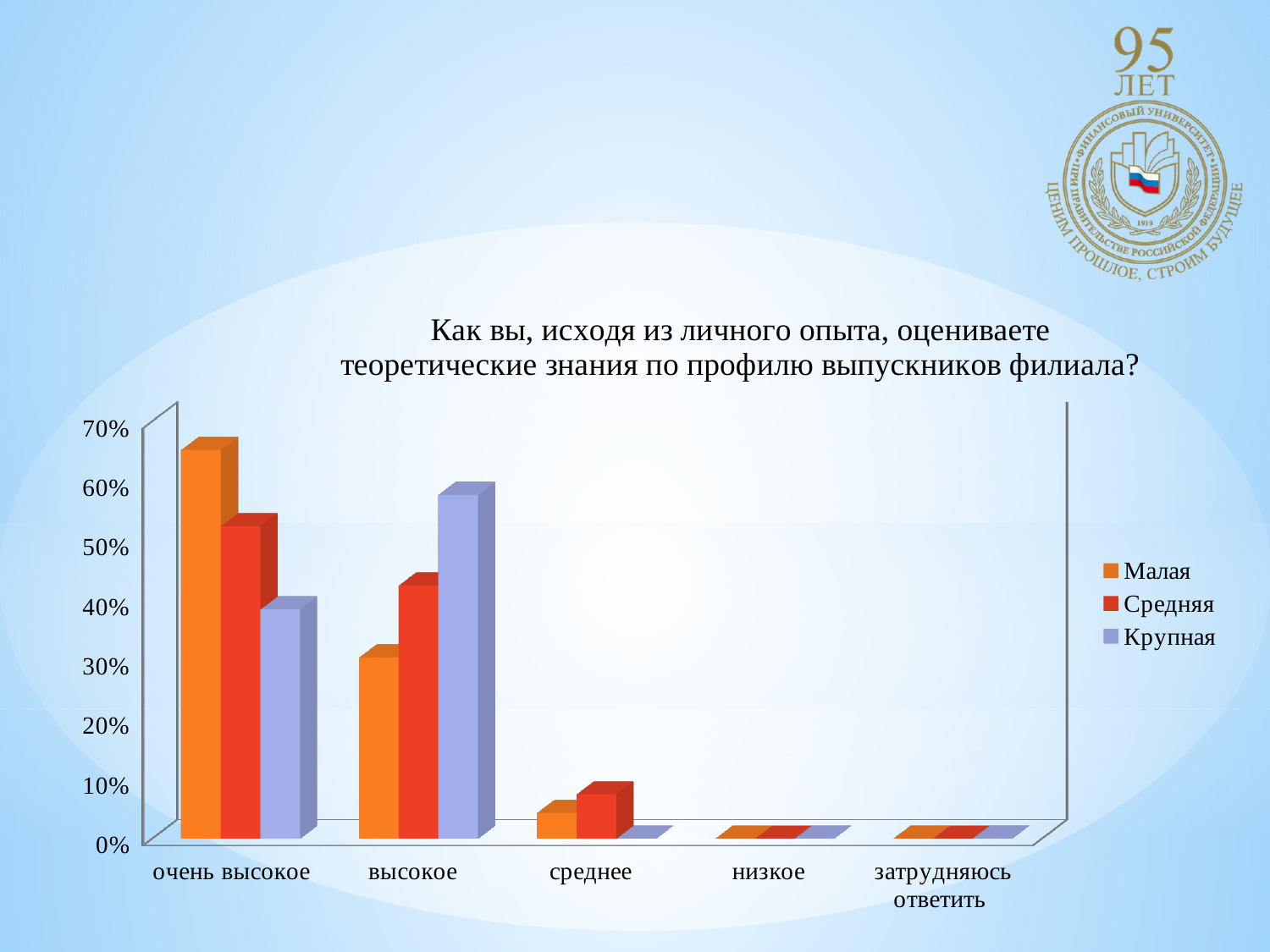
Is the value for "Крупная" in the category "высокое" greater or less than 50%? greater Is the value for "Средняя" in the category "среднее" greater or less than 10%? less In the category "высокое", which is larger: the value for "Малая" or the value for "Средняя"? Средняя What is the title of the chart? Как вы, исходя из личного опыта, оцениваете теоретические знания по профилю выпускников филиала? Is the value for "Малая" in the category "очень высокое" greater or less than 60%? greater How many series does the legend list? 3 What kind of chart is shown on the slide? bar chart How many categories are shown on the x axis? 5 For the series "Малая", which category has the highest bar? очень высокое Which series has the highest bar for the category "высокое"? Крупная Which series has the highest bar for the category "очень высокое"? Малая